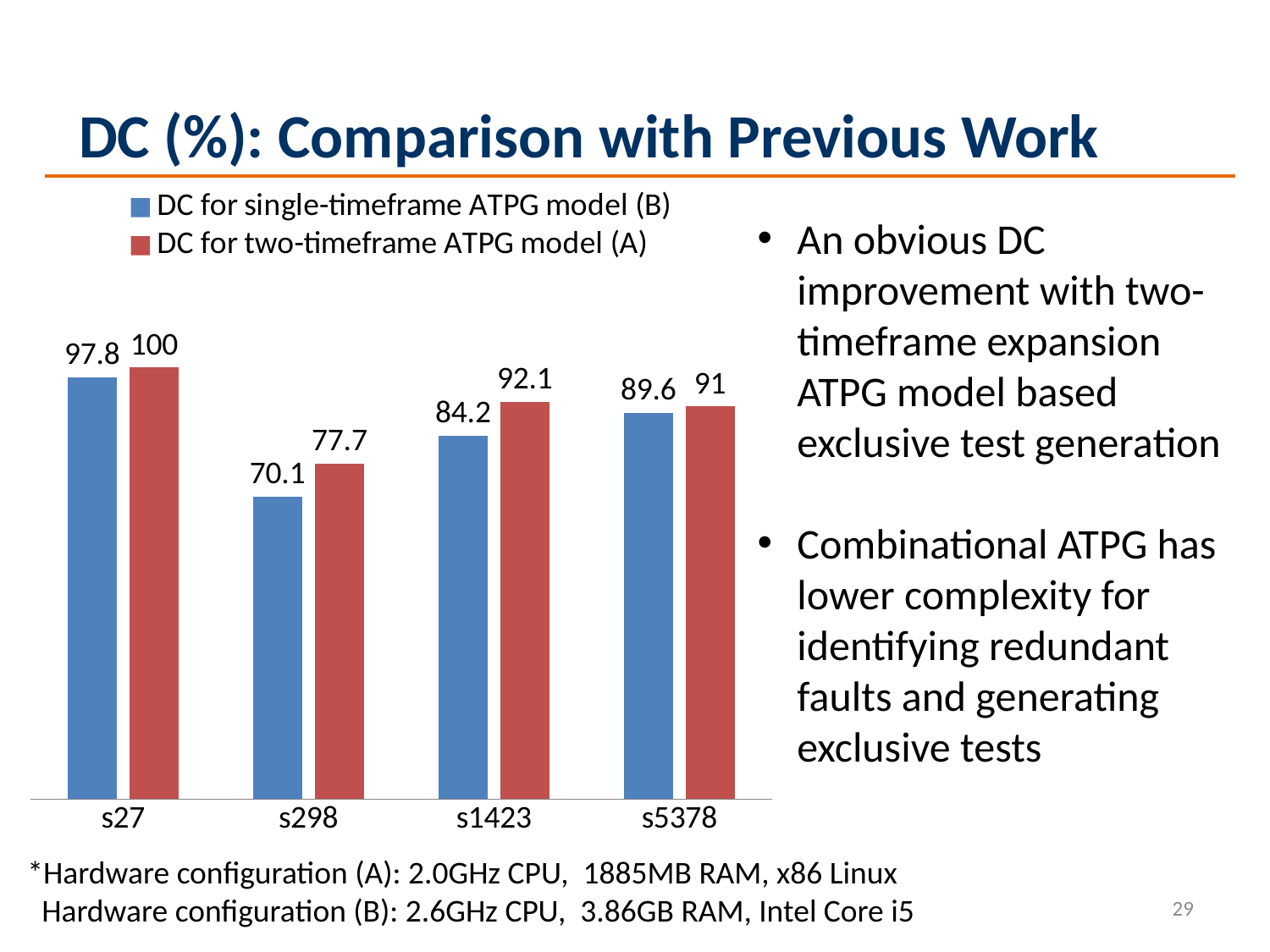
How many series does the chart legend list? 2 What is the difference between the two-timeframe (A) and single-timeframe (B) DC values for s5378? 1.4 What colour are the bars for the DC for two-timeframe ATPG model (A)? Red How many circuits are shown on the x axis of the chart? 4 What is the DC for the two-timeframe ATPG model (A) for s27? 100 Which circuit has the lowest DC for the single-timeframe ATPG model (B)? s298 Which is larger for s1423: the DC for the single-timeframe model (B) or the two-timeframe model (A)? DC for two-timeframe ATPG model (A) What is the DC for the single-timeframe ATPG model (B) for s298? 70.1 What is the DC for the two-timeframe ATPG model (A) for s1423? 92.1 What is the difference between the two-timeframe (A) and single-timeframe (B) DC values for s298? 7.6 Which circuit has the highest DC for the two-timeframe ATPG model (A)? s27 What kind of chart is shown on the slide? Bar chart